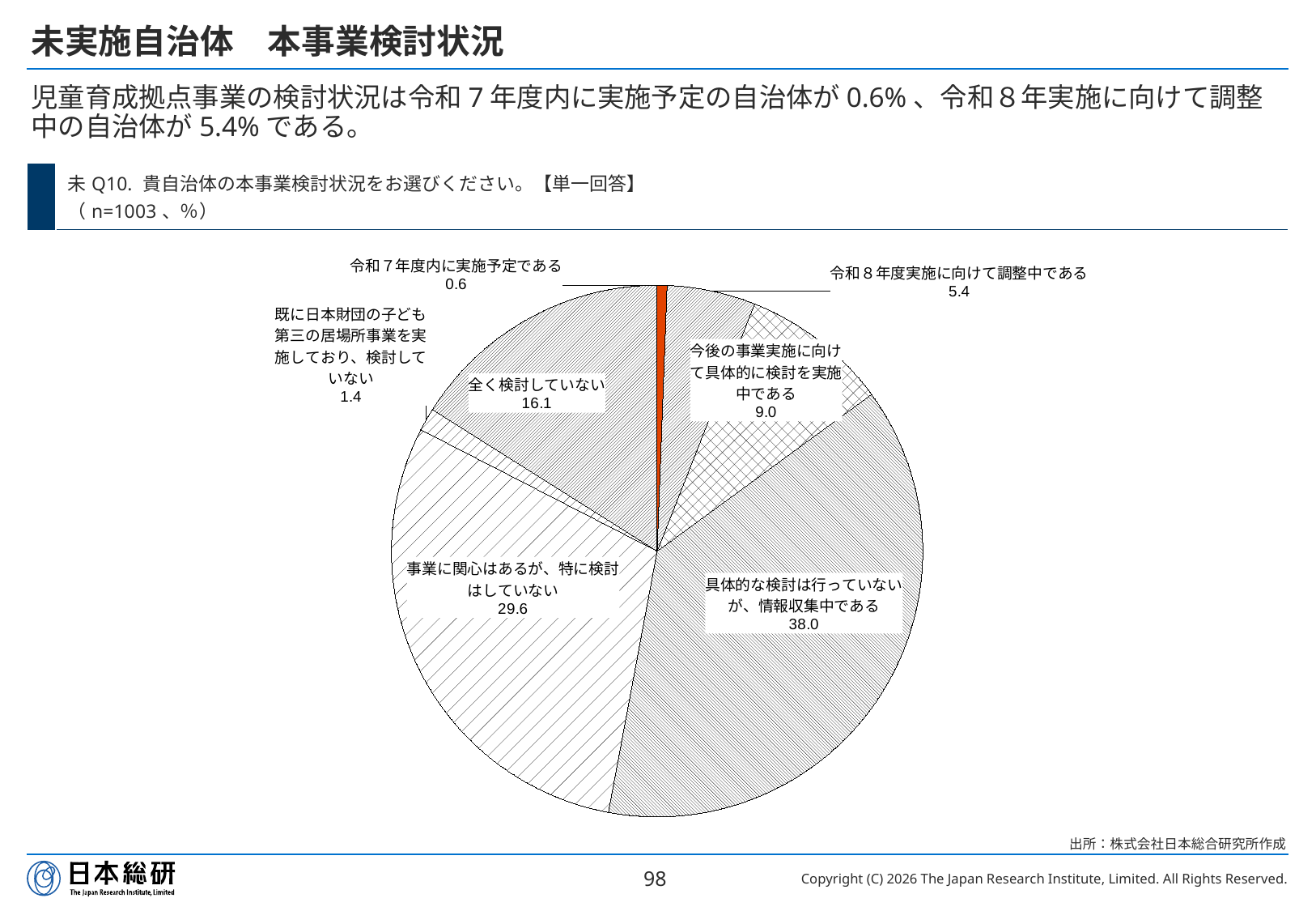
What is the value for 「具体的な検討は行っていないが、情報収集中である」? 38.0 Which category has the smallest share of the pie? 令和７年度内に実施予定である What is the value for 「事業に関心はあるが、特に検討はしていない」? 29.6 Which category has the largest share of the pie? 具体的な検討は行っていないが、情報収集中である What kind of chart is shown on the slide? Pie chart What is the value for 「既に日本財団の子ども第三の居場所事業を実施しており、検討していない」? 1.4 What is the sample size (n) stated for the chart? n=1003 What is the value for 「全く検討していない」? 16.1 What is the value for 「令和８年度実施に向けて調整中である」? 5.4 Which is larger: the value for 「今後の事業実施に向けて具体的に検討を実施中である」 or 「令和８年度実施に向けて調整中である」? 今後の事業実施に向けて具体的に検討を実施中である How many categories (slices) does the pie chart have? 7 What is the difference between the values for 「具体的な検討は行っていないが、情報収集中である」 and 「事業に関心はあるが、特に検討はしていない」? 8.4